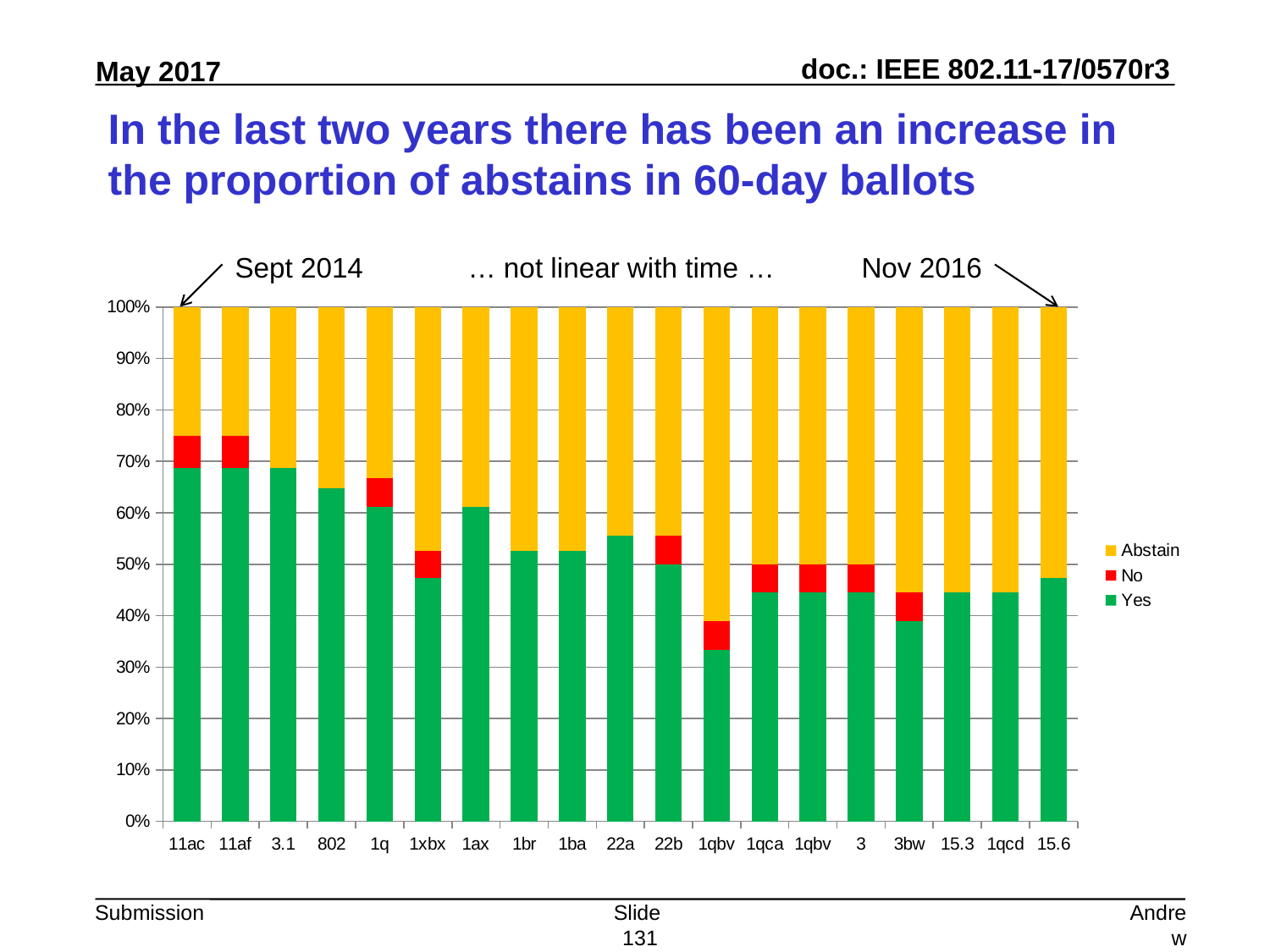
What kind of chart is shown on the slide? stacked bar chart How many series does the legend list? 3 Is the Yes proportion for 11ac greater or less than 60%? greater Is the Yes proportion for 802 greater or less than 60%? greater Does the Yes proportion generally rise or fall from left to right across the ballots? fall Which colour represents Abstain in the legend? yellow Which has the larger Yes proportion, 3.1 or 3bw? 3.1 Is the Yes proportion for 15.6 greater or less than 50%? less Which ballot has the lowest Yes proportion? 1qbv Which has the larger Abstain proportion, 11ac or 1qbv? 1qbv How many ballots (categories) are shown along the x axis? 19 What does each stacked bar total? 100%